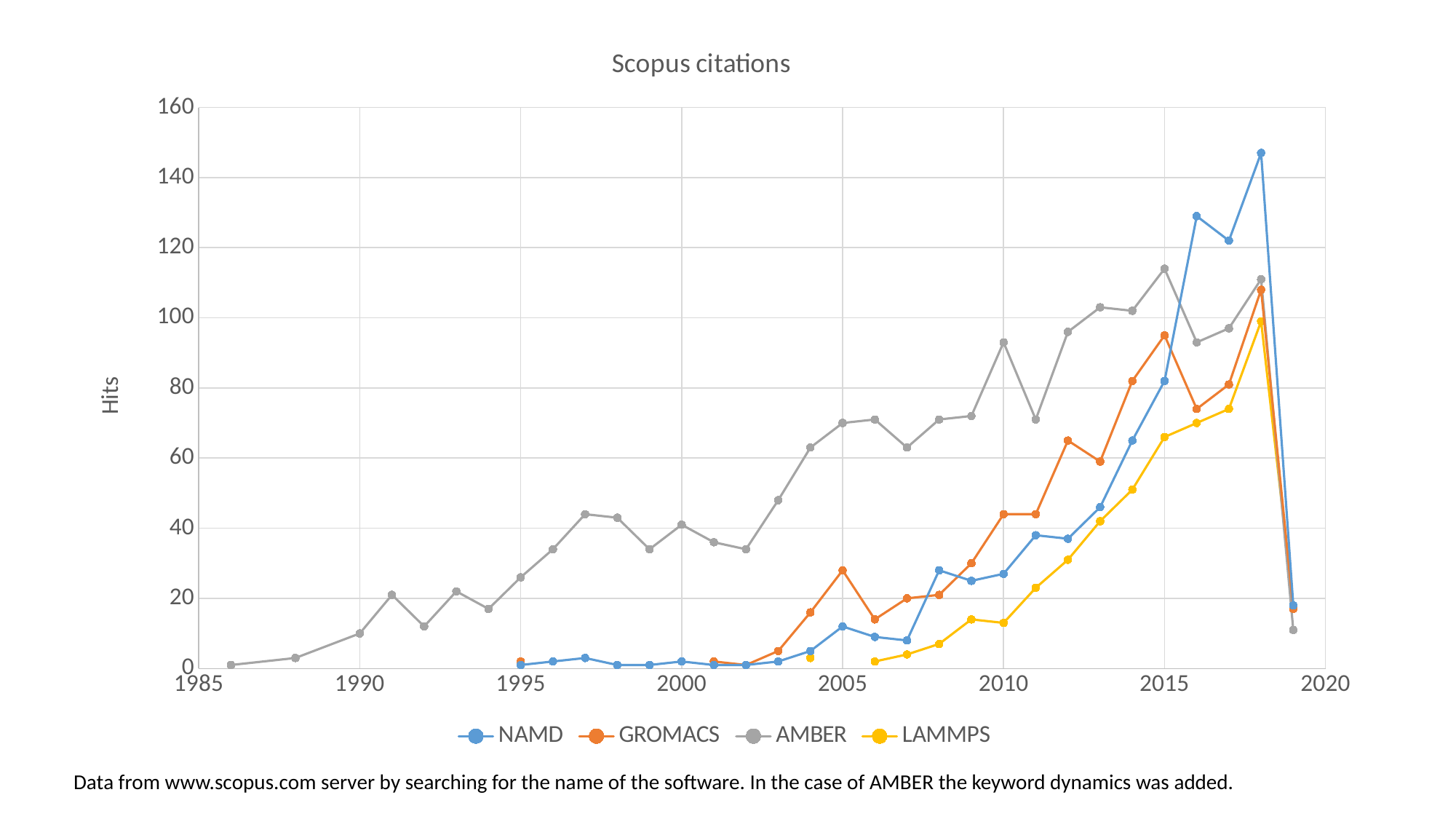
What is the title of the chart? Scopus citations Which series reaches the highest value anywhere on the chart? NAMD Is the value for AMBER in 2015 greater or less than 100? greater In 2010, which series has the larger value, AMBER or NAMD? AMBER How many series does the legend list? 4 Is the value for LAMMPS in 2010 greater or less than 20? less What kind of chart is shown on the slide? line chart Is the value for NAMD in 2018 greater or less than 140? greater In 2018, which series has the larger value, NAMD or LAMMPS? NAMD Which series are listed in the legend? NAMD, GROMACS, AMBER, LAMMPS Does the AMBER series generally rise or fall from 1986 to 2015? rise